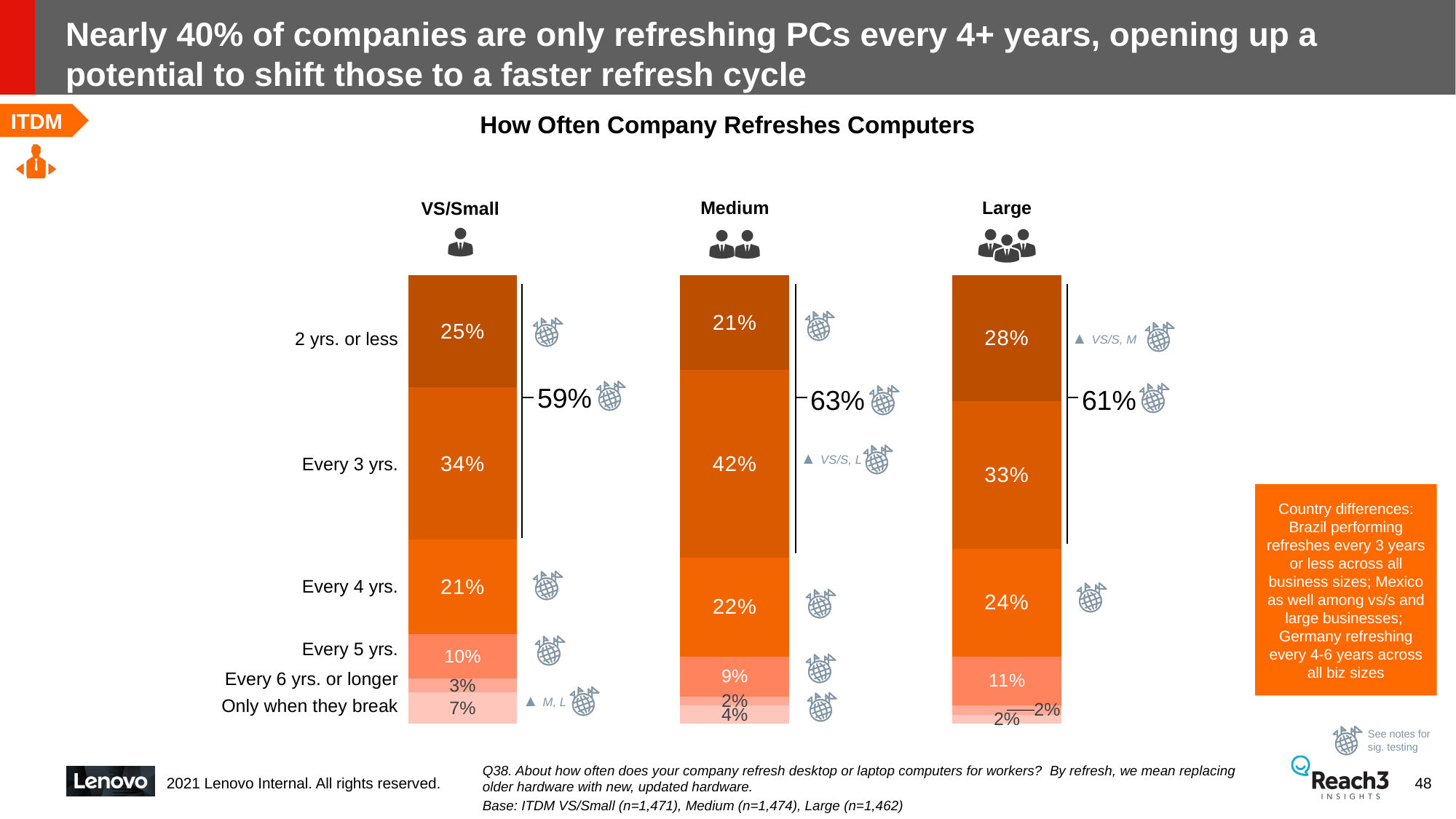
What percentage of VS/Small companies refresh computers only when they break? 7% How many refresh-frequency categories are shown in each stacked bar? 6 What percentage of Large companies refresh computers every 2 years or less? 28% What percentage of Medium companies refresh computers every 3 years? 42% Which business size has the lowest share of companies refreshing every 2 years or less? Medium Is the 'Every 4 yrs.' share larger for Large or for VS/Small companies? Large What is the title of the chart? How Often Company Refreshes Computers Which business size has the highest share of companies refreshing every 3 years? Medium How many business-size groups (bars) are shown in the chart? 3 What is the combined share of Medium companies refreshing every 3 years or less, as shown by the bracket label? 63% What is the difference between the 'Every 3 yrs.' share for Medium and for VS/Small? 8 percentage points What type of chart is used to show how often companies refresh computers? Stacked bar chart